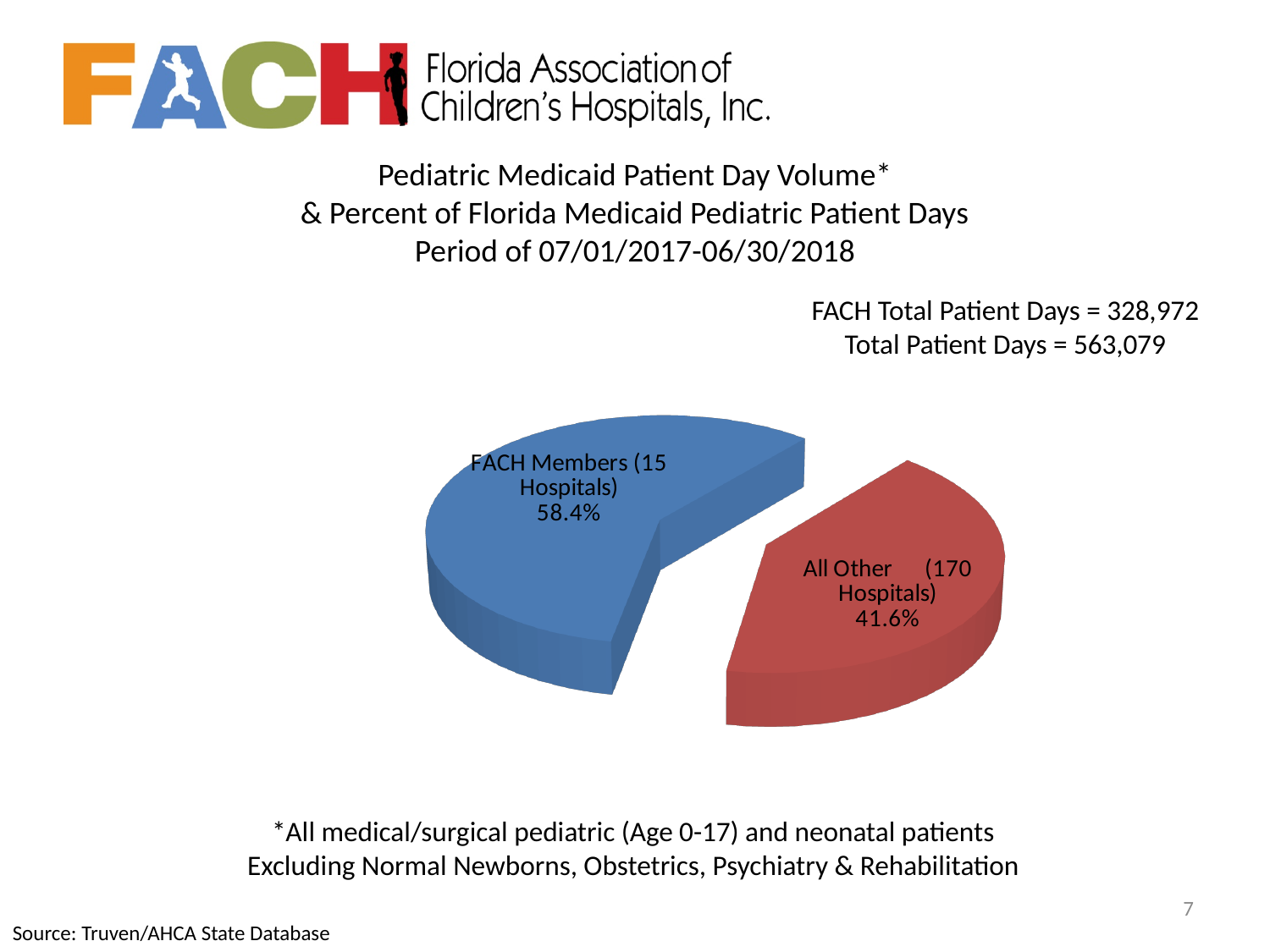
What share of the pie does FACH Members (15 Hospitals) represent? 58.4% Which is larger: the FACH Members slice or the All Other slice? FACH Members What is the difference in percentage points between the FACH Members slice and the All Other slice? 16.8 percentage points How many hospitals are included in the All Other slice? 170 What period does the chart cover? 07/01/2017-06/30/2018 Which slice of the pie is the largest? FACH Members (15 Hospitals) Is the share for All Other (170 Hospitals) greater or less than 50%? less What share of the pie does All Other (170 Hospitals) represent? 41.6% Which slice of the pie is the smallest? All Other (170 Hospitals) What type of chart is shown on the slide? Pie chart How many slices does the pie chart have? 2 What colour is the FACH Members slice? Blue